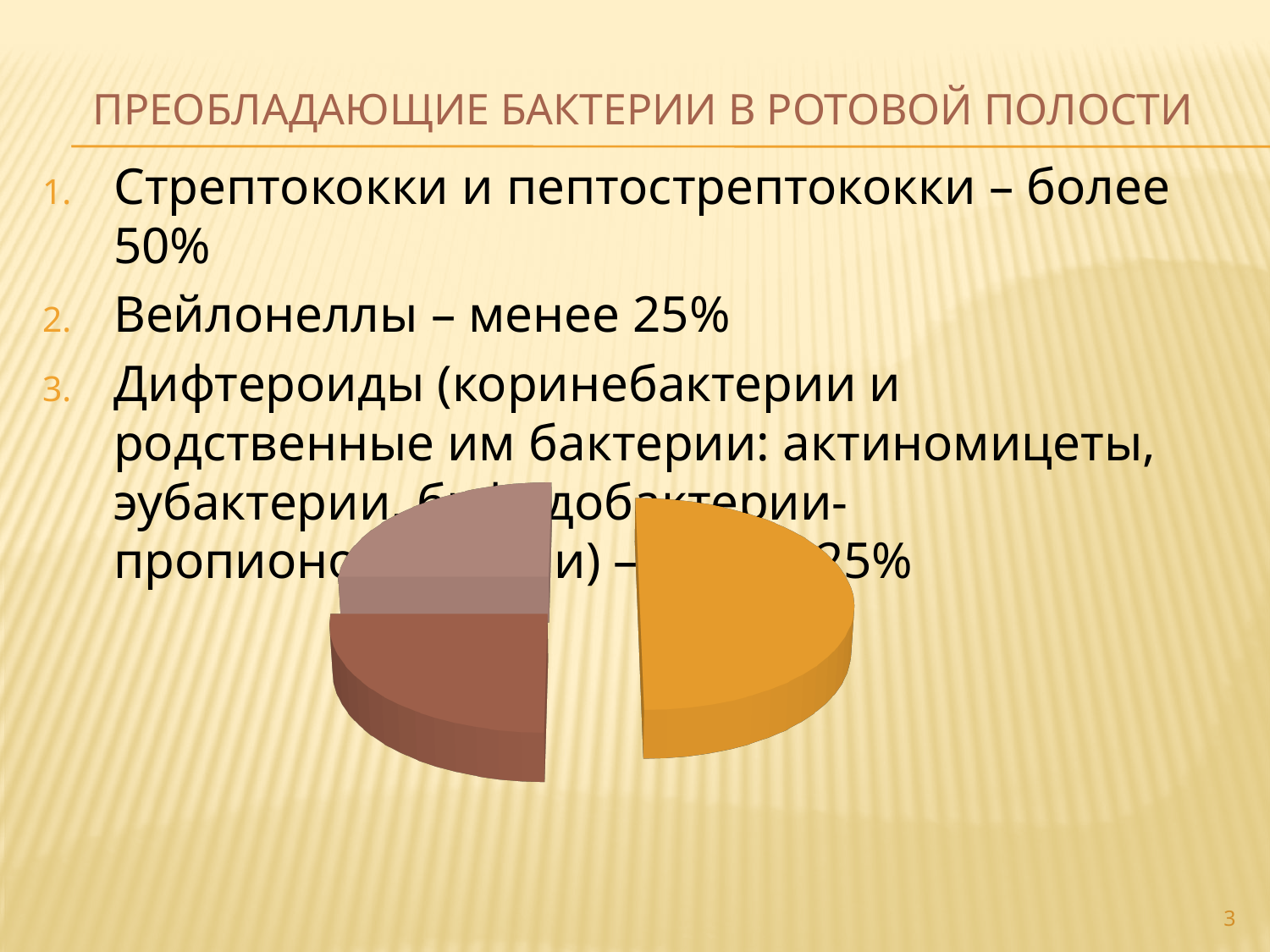
Does the pie chart display a legend? No Are any data labels printed on the pie chart slices? No How many slices does the pie chart have? 3 What kind of chart is shown on the slide? pie chart Which colour slice of the pie chart is the largest? orange